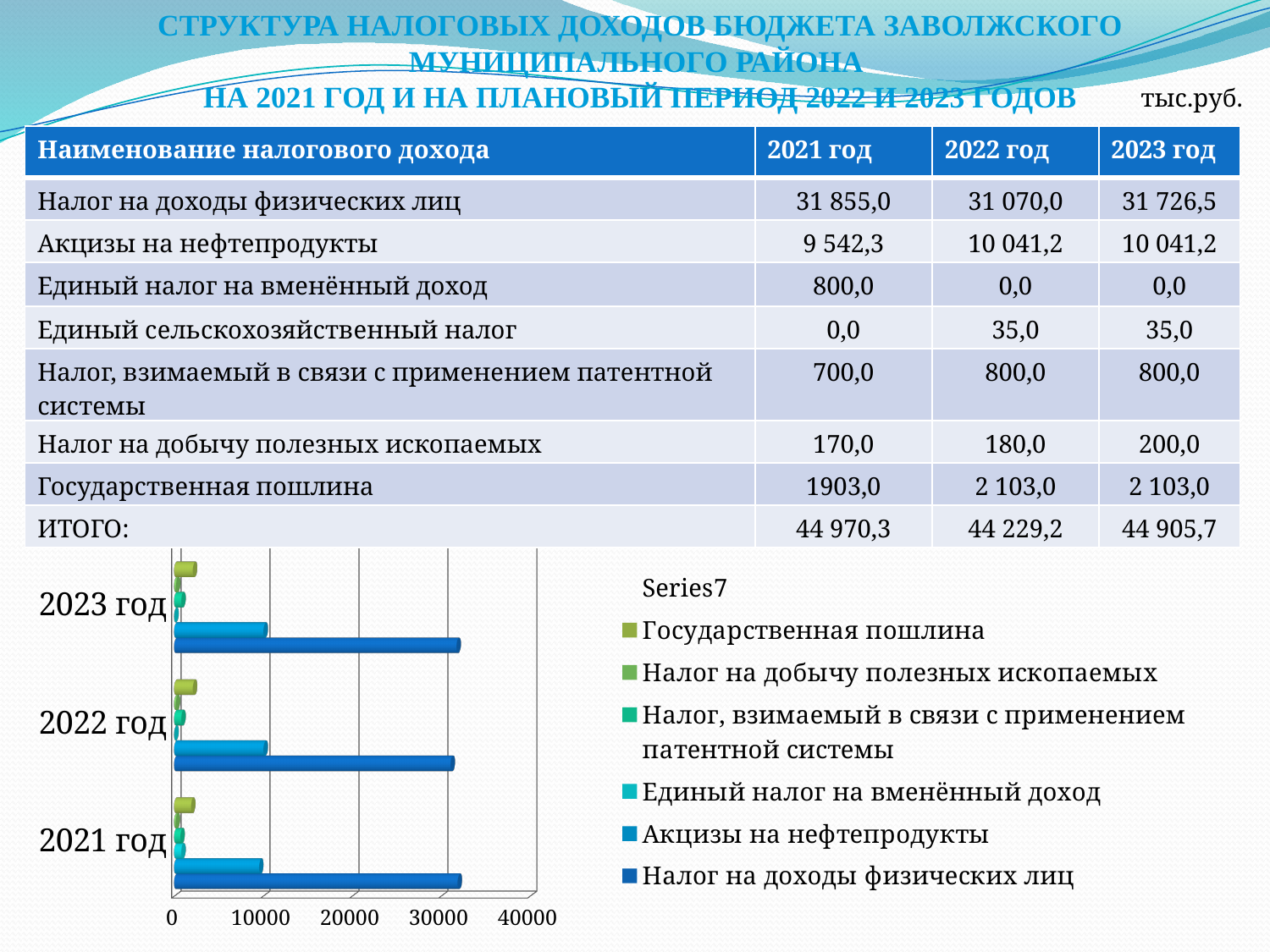
How many entries does the legend of the bar chart list? 7 According to the slide, what is the value of Государственная пошлина for 2022 год? 2 103,0 In the bar chart, which is larger for 2021 год: Налог на доходы физических лиц or Акцизы на нефтепродукты? Налог на доходы физических лиц In the bar chart, is the value for Налог на доходы физических лиц in 2023 год greater or less than 30000? greater In the bar chart, is the value for Государственная пошлина in 2021 год greater or less than 10000? less In the bar chart, is the value for Акцизы на нефтепродукты in 2022 год greater or less than 20000? less What is the highest tick value shown on the horizontal axis of the bar chart? 40000 According to the slide, what is the value of Акцизы на нефтепродукты for 2023 год? 10 041,2 According to the slide, what is the value of Налог на доходы физических лиц for 2021 год? 31 855,0 What kind of chart is shown at the bottom left of the slide? bar chart Which legend entry of the bar chart is shown in dark blue? Налог на доходы физических лиц How many year categories are shown on the vertical axis of the bar chart? 3